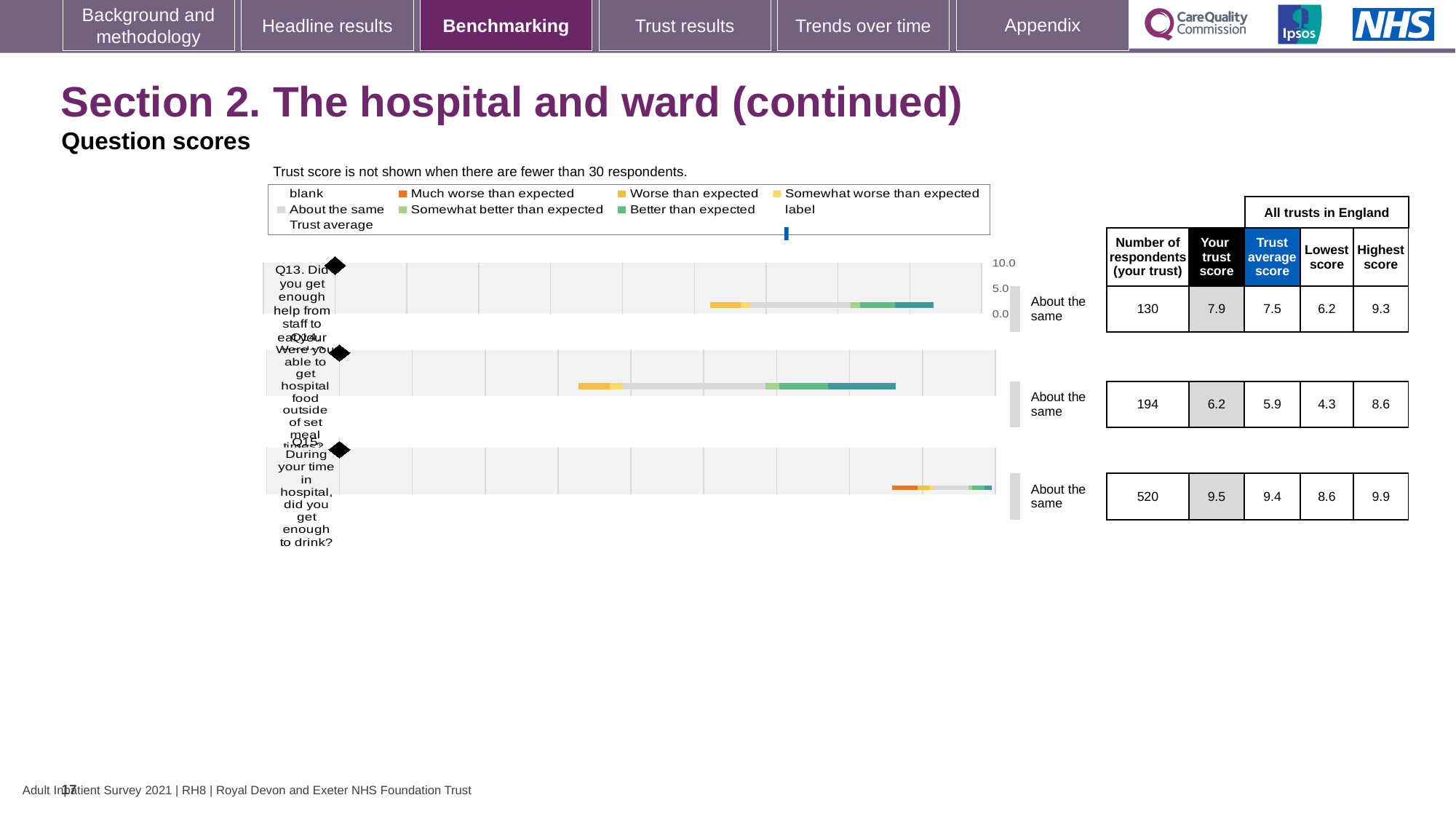
How many questions (Q13, Q14, Q15) are plotted on the slide? 3 What is the 'Your trust score' for Q13 (Did you get enough help from staff to eat your meals?)? 7.9 What is the trust average score for Q15 (During your time in hospital, did you get enough to drink?)? 9.4 What is the difference between the 'Your trust score' and the trust average score for Q13? 0.4 How many respondents from your trust answered Q14 (Were you able to get hospital food outside of set meal times?)? 194 What kind of chart is used to show the question scores on this slide? bar chart Which legend entry is shown in dark orange? Much worse than expected For Q14, which is larger: the 'Your trust score' or the trust average score? Your trust score What is the highest score across all trusts in England for Q14? 8.6 Which question has the highest 'Your trust score'? Q15 Is the trust score marker for Q15 greater or less than 5.0 on the axis? greater Which question has the lowest 'Your trust score'? Q14